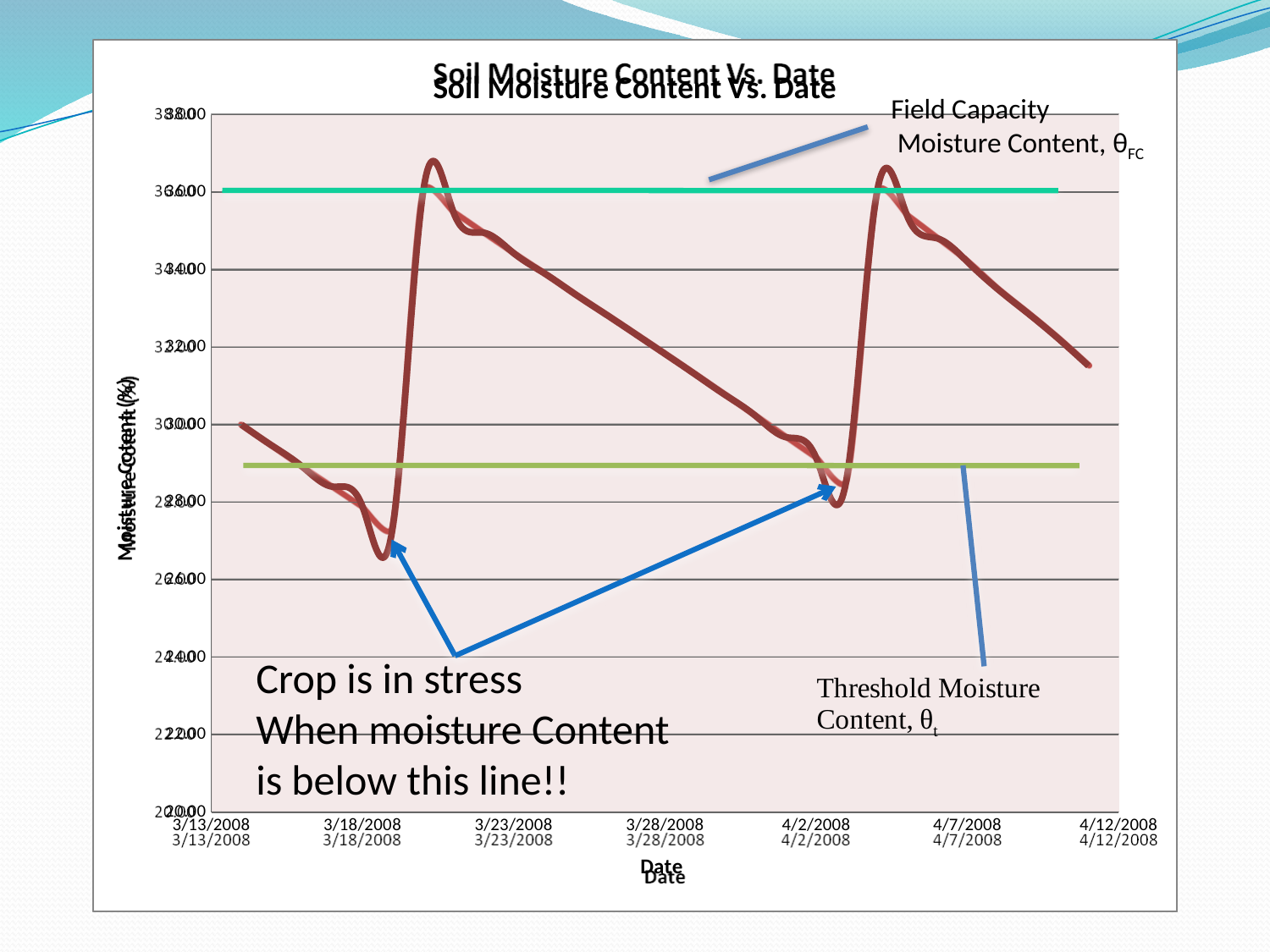
What kind of chart is shown on the slide? line chart Is the soil moisture content higher on 3/23/2008 or on 4/2/2008? 3/23/2008 What label is given to the upper horizontal green line on the chart? Field Capacity Moisture Content, θFC What is the last date shown on the x axis? 4/12/2008 What is the title of the chart? Soil Moisture Content Vs. Date Does the soil moisture content rise or fall between 3/13/2008 and 3/18/2008? fall How many date ticks are shown along the x axis? 7 Does the soil moisture content rise or fall between 4/7/2008 and 4/12/2008? fall What is the first date shown on the x axis? 3/13/2008 Does the soil moisture content rise or fall between 3/23/2008 and 3/28/2008? fall Which horizontal reference line sits higher on the chart, the Field Capacity line or the Threshold Moisture Content line? Field Capacity